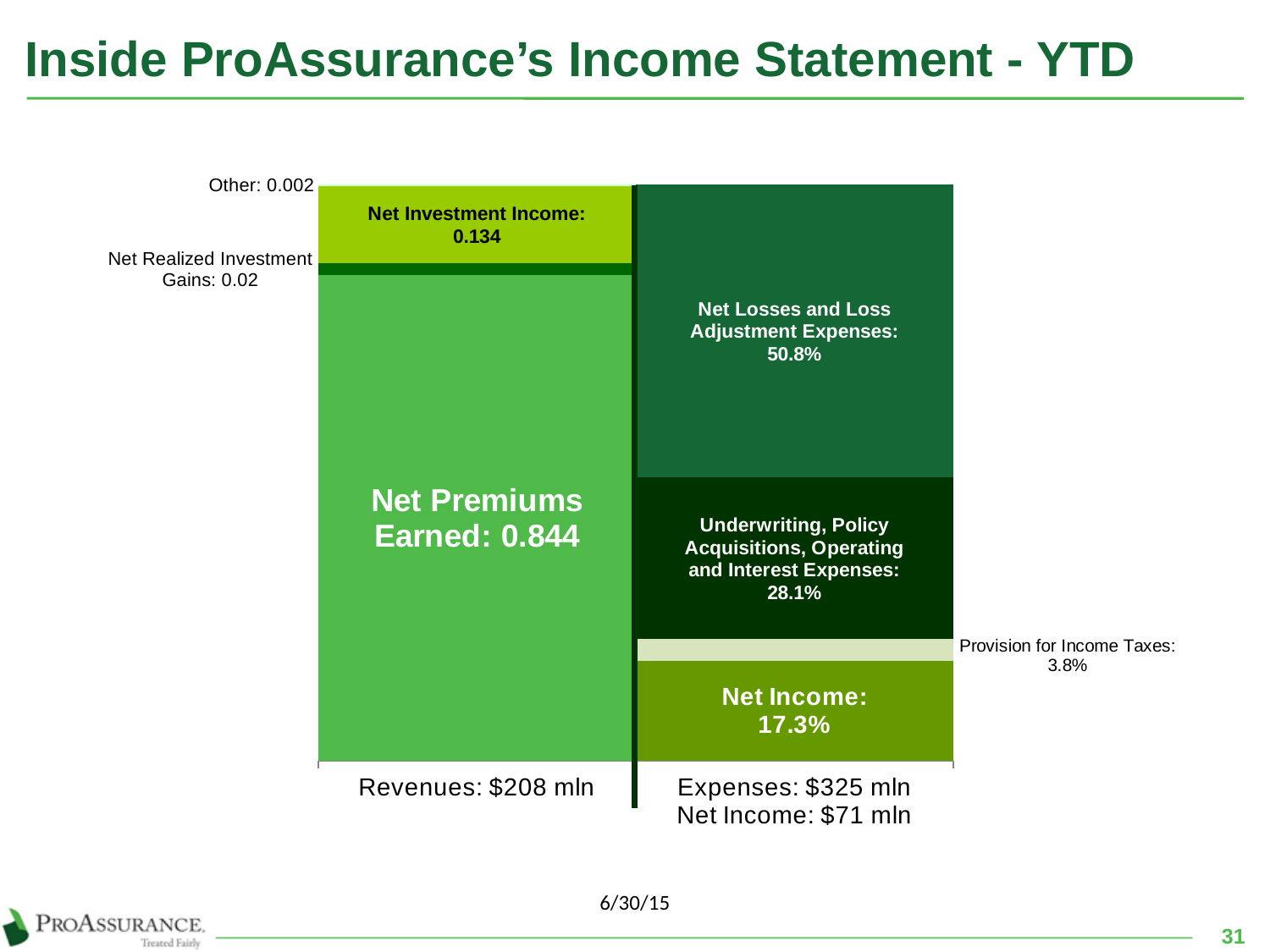
What is the value shown for Net Realized Investment Gains? 0.02 What is the difference between the Net Losses and Loss Adjustment Expenses percentage and the Underwriting, Policy Acquisitions, Operating and Interest Expenses percentage? 22.7% What kind of chart is shown on the slide? Stacked bar chart Which segment of the right-hand bar has the smallest percentage? Provision for Income Taxes What total revenue amount is printed below the left bar? $208 mln Which segment of the revenues bar is the largest? Net Premiums Earned What percentage is shown for Net Losses and Loss Adjustment Expenses? 50.8% What is the value shown for Net Investment Income? 0.134 What percentage is shown for Net Income in the right-hand bar? 17.3% Which is larger: Net Investment Income or Net Realized Investment Gains? Net Investment Income What is the value shown for Net Premiums Earned in the revenues bar? 0.844 What percentage is shown for Provision for Income Taxes? 3.8%